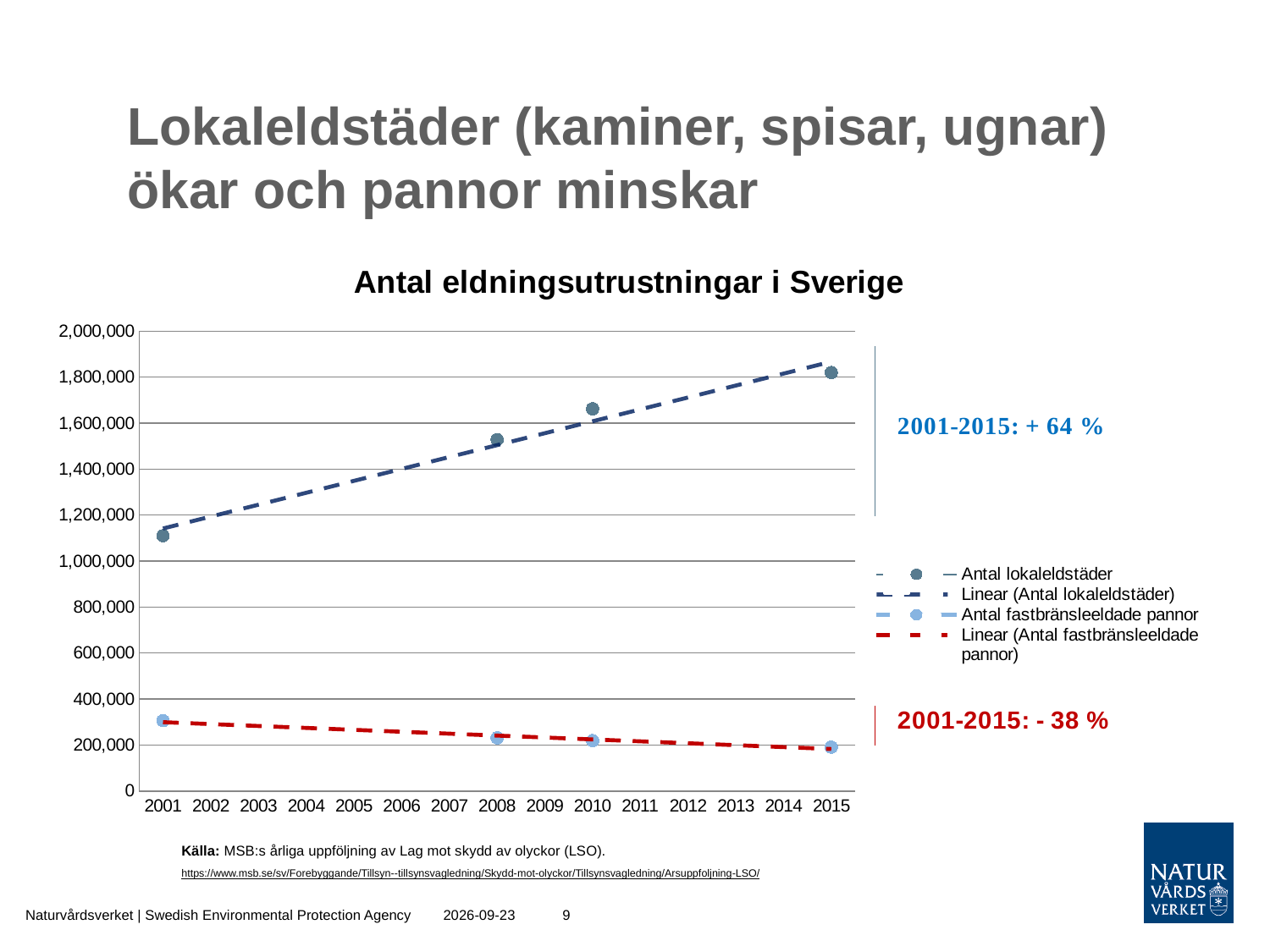
In 2015, which is larger: Antal lokaleldstäder or Antal fastbränsleeldade pannor? Antal lokaleldstäder How many entries does the chart legend list? 4 In which year is Antal lokaleldstäder highest? 2015 What kind of chart is shown on the slide? line chart Is the value for Antal fastbränsleeldade pannor in 2001 greater or less than 400,000? less Is the value for Antal lokaleldstäder in 2010 greater or less than 1,600,000? greater What is the title of the chart? Antal eldningsutrustningar i Sverige In which year is Antal fastbränsleeldade pannor lowest? 2015 Does the value for Antal fastbränsleeldade pannor rise or fall from 2001 to 2015? fall Does the value for Antal lokaleldstäder rise or fall from 2001 to 2015? rise In which year is Antal fastbränsleeldade pannor highest? 2001 What percentage change for 2001-2015 is shown in red on the slide? - 38 %